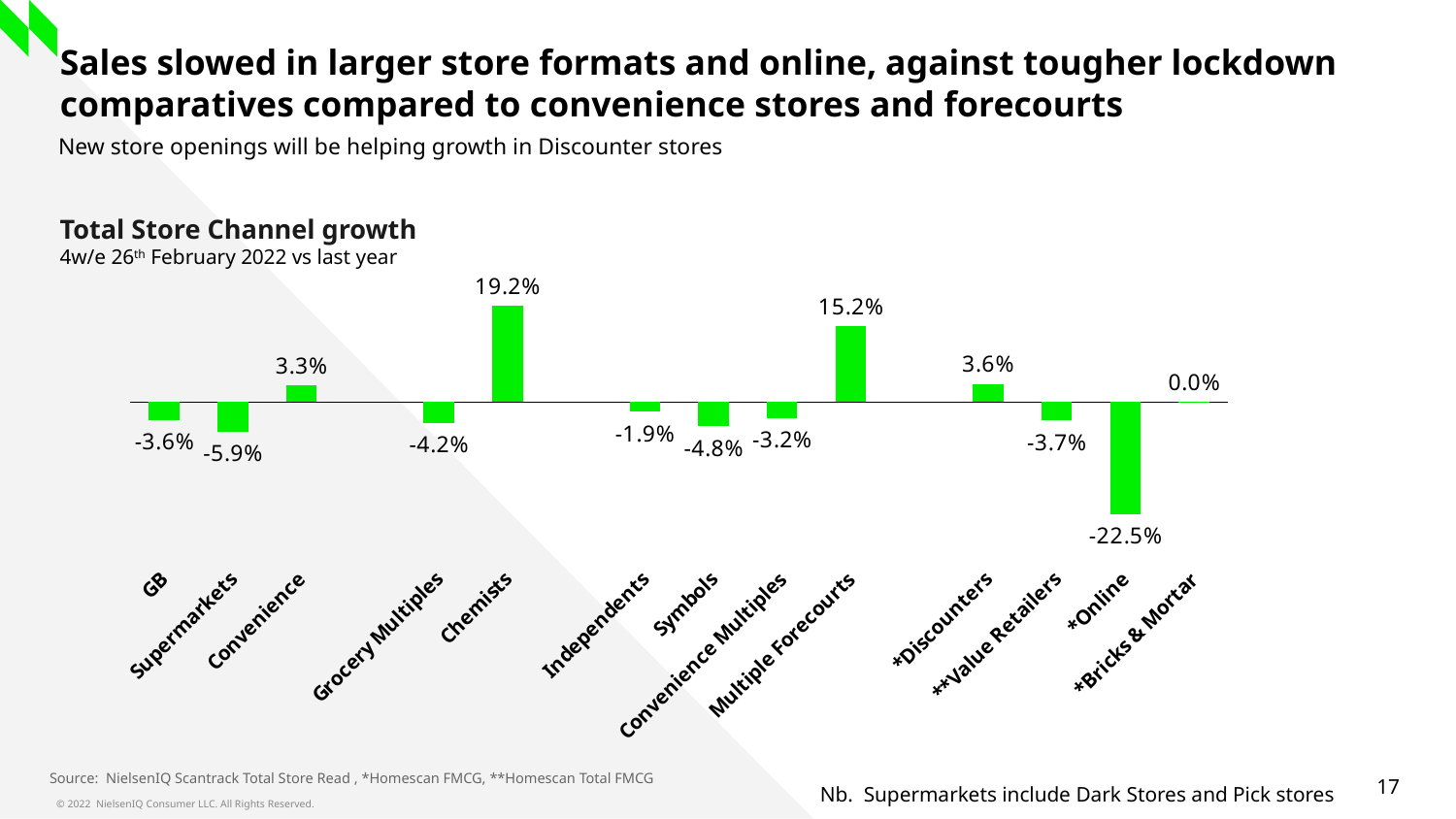
How many channels are shown on the chart? 13 Which channel has the highest growth? Chemists Which channel has the lowest growth? *Online What type of chart is used to show Total Store Channel growth? Bar chart What is the growth value for Chemists? 19.2% Which has higher growth, Convenience or *Discounters? *Discounters What is the growth value for *Bricks & Mortar? 0.0% What is the growth value for *Online? -22.5% What is the growth value for Multiple Forecourts? 15.2% What period does the chart cover? 4w/e 26th February 2022 vs last year What is the difference between the growth for Chemists and Multiple Forecourts? 4.0 percentage points What is the growth value for Supermarkets? -5.9%